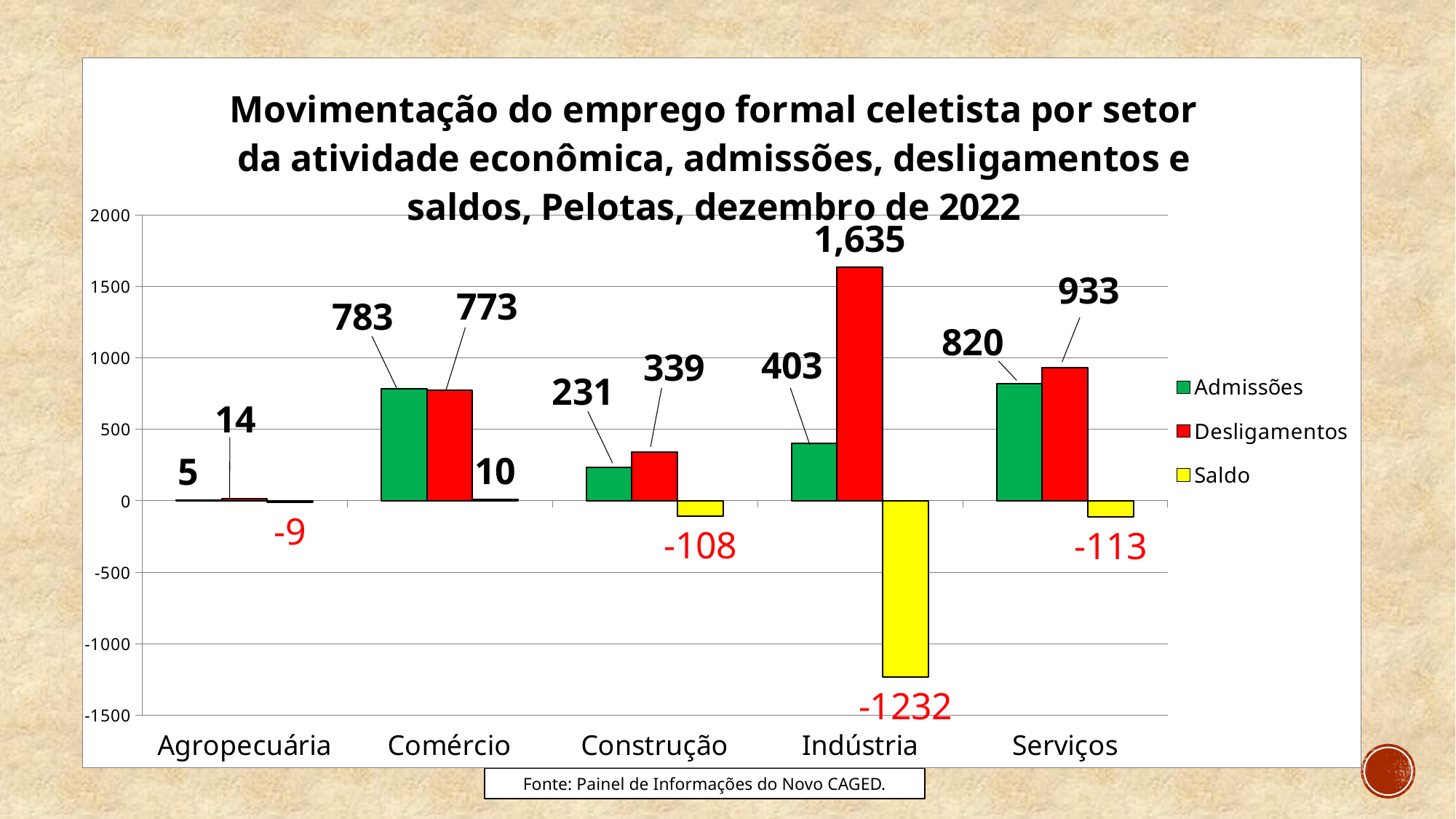
Is the Desligamentos value for Indústria greater or less than 1500? greater What is the Saldo value for Serviços? -113 Which is larger for Serviços, Admissões or Desligamentos? Desligamentos What is the Admissões value for Comércio? 783 How many series does the legend list? 3 Which sector has the lowest Admissões value? Agropecuária Which sector has the highest Desligamentos value? Indústria What is the difference between Desligamentos and Admissões for Construção? 108 How many sectors are shown on the x axis? 5 What is the Saldo value for Agropecuária? -9 What kind of chart is shown on the slide? Bar chart What is the Desligamentos value for Indústria? 1,635